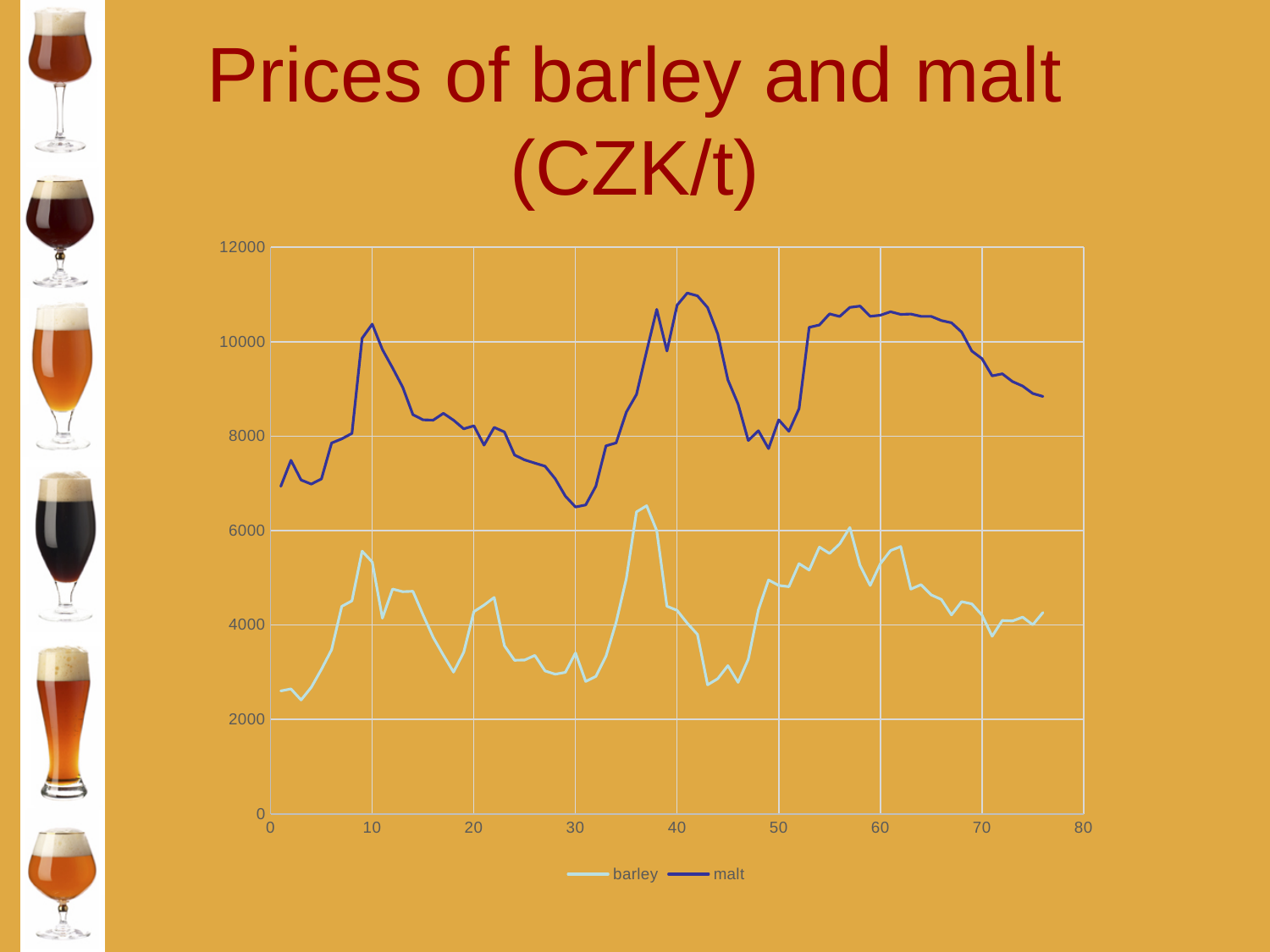
What kind of chart is shown on the slide? line chart Is the value for barley at x = 10 greater or less than 4000? greater How many series does the legend list? 2 Is the value for malt at x = 10 greater or less than 10000? greater What is the title of the chart? Prices of barley and malt (CZK/t) Is the value for malt at x = 30 greater or less than 8000? less Which series stays higher than the other across the whole x axis? malt At x = 40, which series has the larger value, barley or malt? malt What are the two series named in the legend? barley and malt